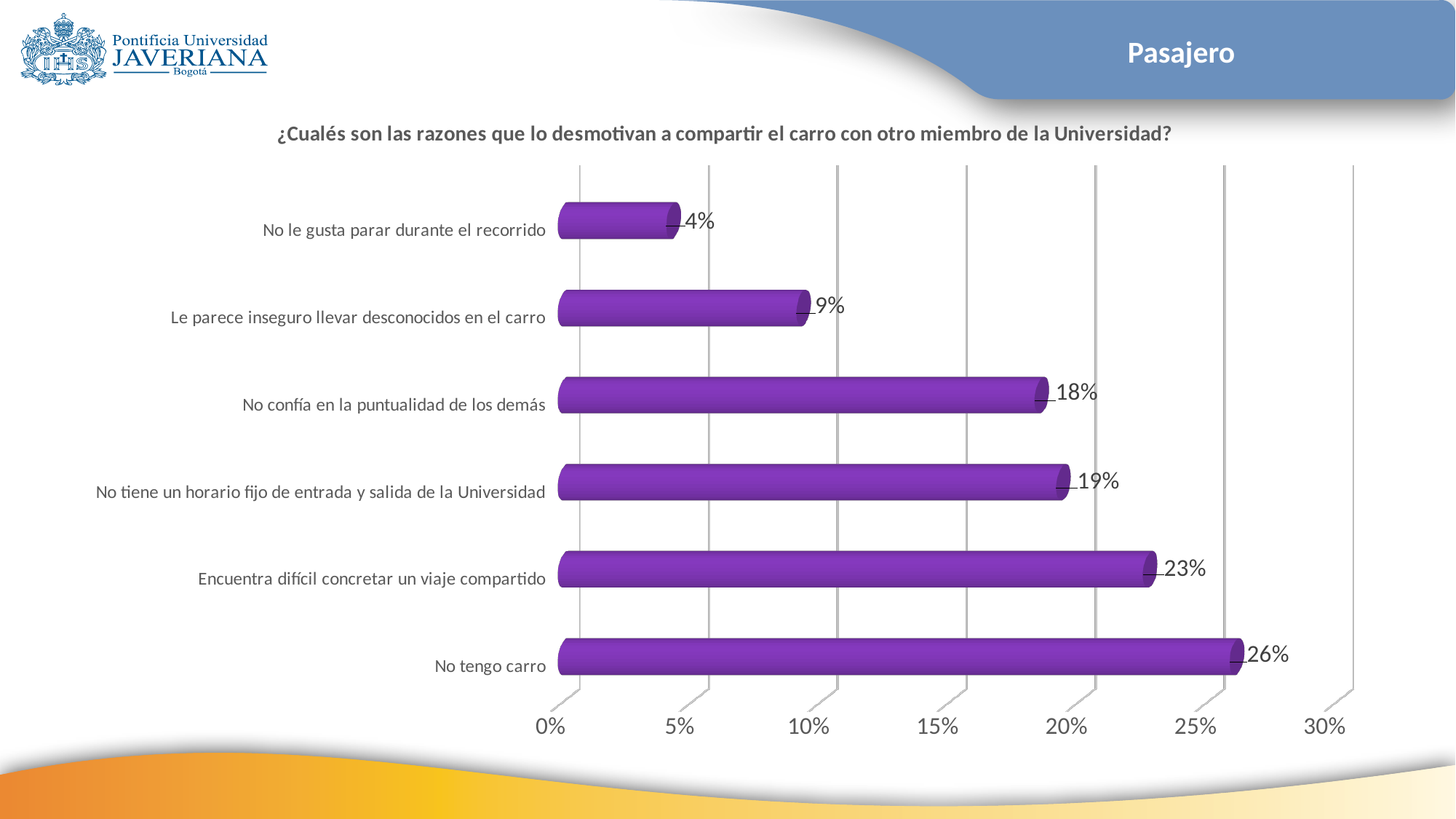
Which category has the lowest value? No le gusta parar durante el recorrido What is the title of the chart? ¿Cualés son las razones que lo desmotivan a compartir el carro con otro miembro de la Universidad? What is the value for "No tengo carro"? 26% What kind of chart is shown on the slide? Bar chart What is the difference between the values for "No tengo carro" and "Encuentra difícil concretar un viaje compartido"? 3% What is the value for "No confía en la puntualidad de los demás"? 18% What is the value for "No le gusta parar durante el recorrido"? 4% Which category has the highest value? No tengo carro How many categories are shown in the chart? 6 Is the value for "Encuentra difícil concretar un viaje compartido" greater or less than 20%? greater What is the difference between the values for "Le parece inseguro llevar desconocidos en el carro" and "No le gusta parar durante el recorrido"? 5% Which is larger: the value for "No tiene un horario fijo de entrada y salida de la Universidad" or for "No confía en la puntualidad de los demás"? No tiene un horario fijo de entrada y salida de la Universidad